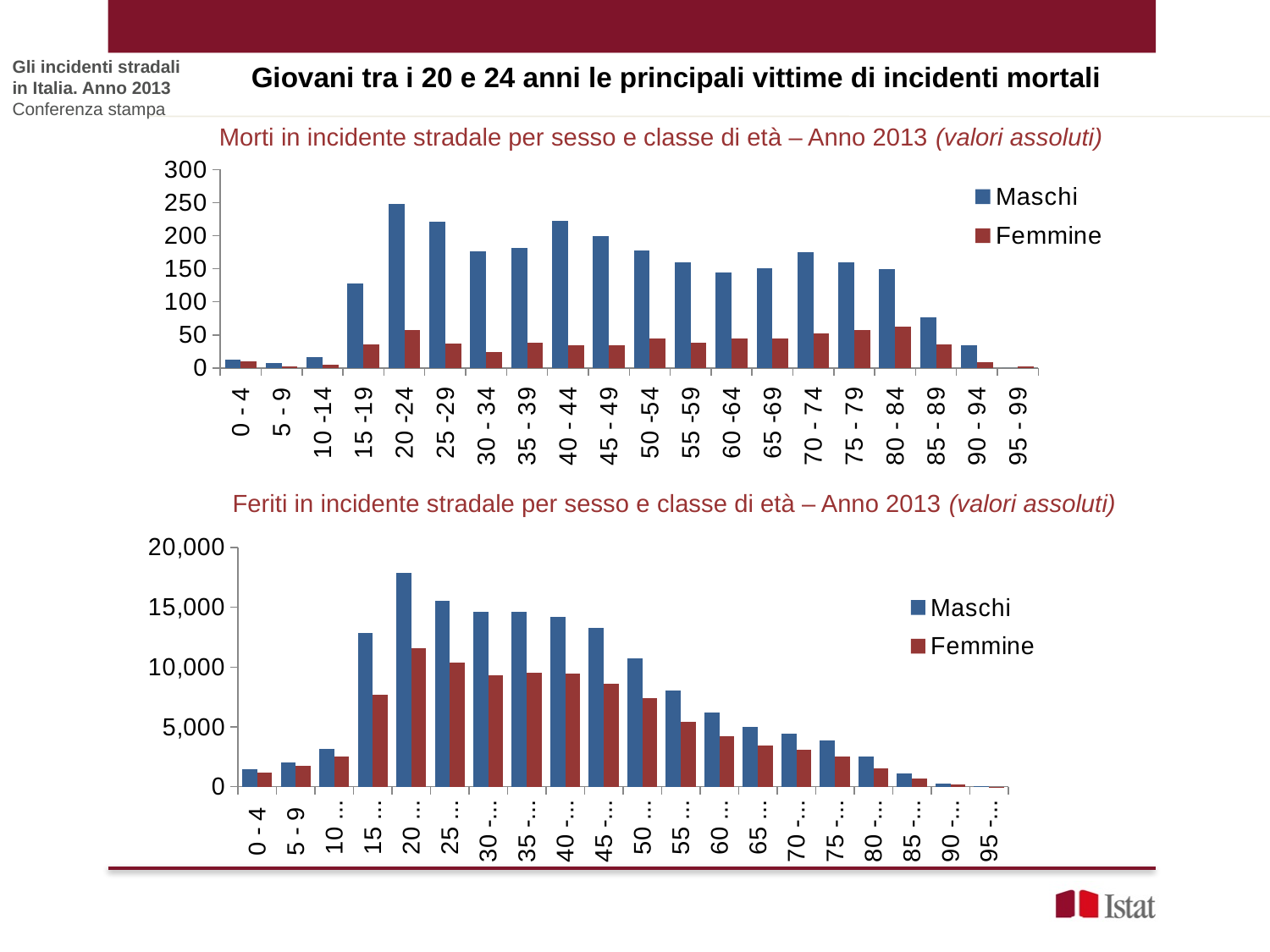
What are the two legend entries in the bottom chart, 'Feriti in incidente stradale per sesso e classe di età'? Maschi, Femmine In the top chart (Morti in incidente stradale), is the Maschi value for the 20 -24 age class greater or less than 200? greater In the bottom chart (Feriti in incidente stradale), is the Maschi value for the age class starting at 20 greater or less than 15,000? greater What type of chart is the top chart, 'Morti in incidente stradale per sesso e classe di età'? bar chart In the top chart (Morti in incidente stradale), is the Maschi value for the 90 - 94 age class greater or less than 50? less In the top chart (Morti in incidente stradale), which is larger for Maschi: the 20 -24 age class or the 25 -29 age class? 20 -24 In the bottom chart (Feriti in incidente stradale), which age class has the highest value for Maschi? the age class starting at 20 In the top chart (Morti in incidente stradale), how many age classes are shown on the x axis? 20 In the top chart (Morti in incidente stradale), how many series does the legend list? 2 In the top chart (Morti in incidente stradale), which age class has the highest value for Maschi? 20 -24